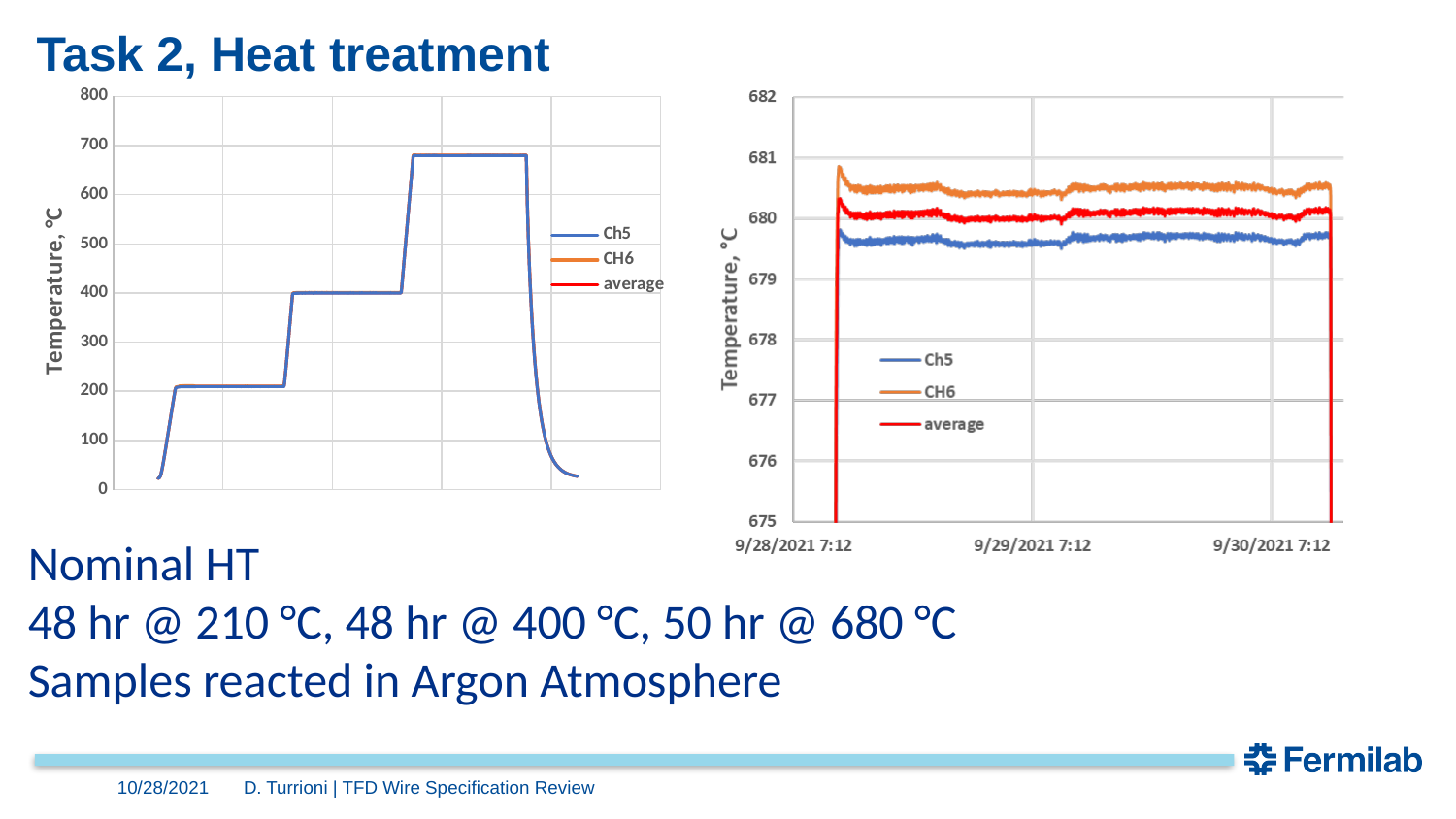
How many series does the legend of the right chart list? 3 On the right chart, which series is plotted higher, CH6 or Ch5? CH6 On the left chart, is the highest plateau greater or less than 600? greater On the left chart, is the first (lowest) plateau greater or less than 200? greater On the left chart, what temperature does the middle plateau sit at? 400 What are the legend entries of the left chart? Ch5, CH6, average On the right chart, is the Ch5 line greater or less than 680? less What kind of chart is the left chart on the slide? line chart How many date labels are shown on the x axis of the right chart? 3 What is the y-axis label of the right chart? Temperature, °C On the right chart, which series is plotted lowest? Ch5